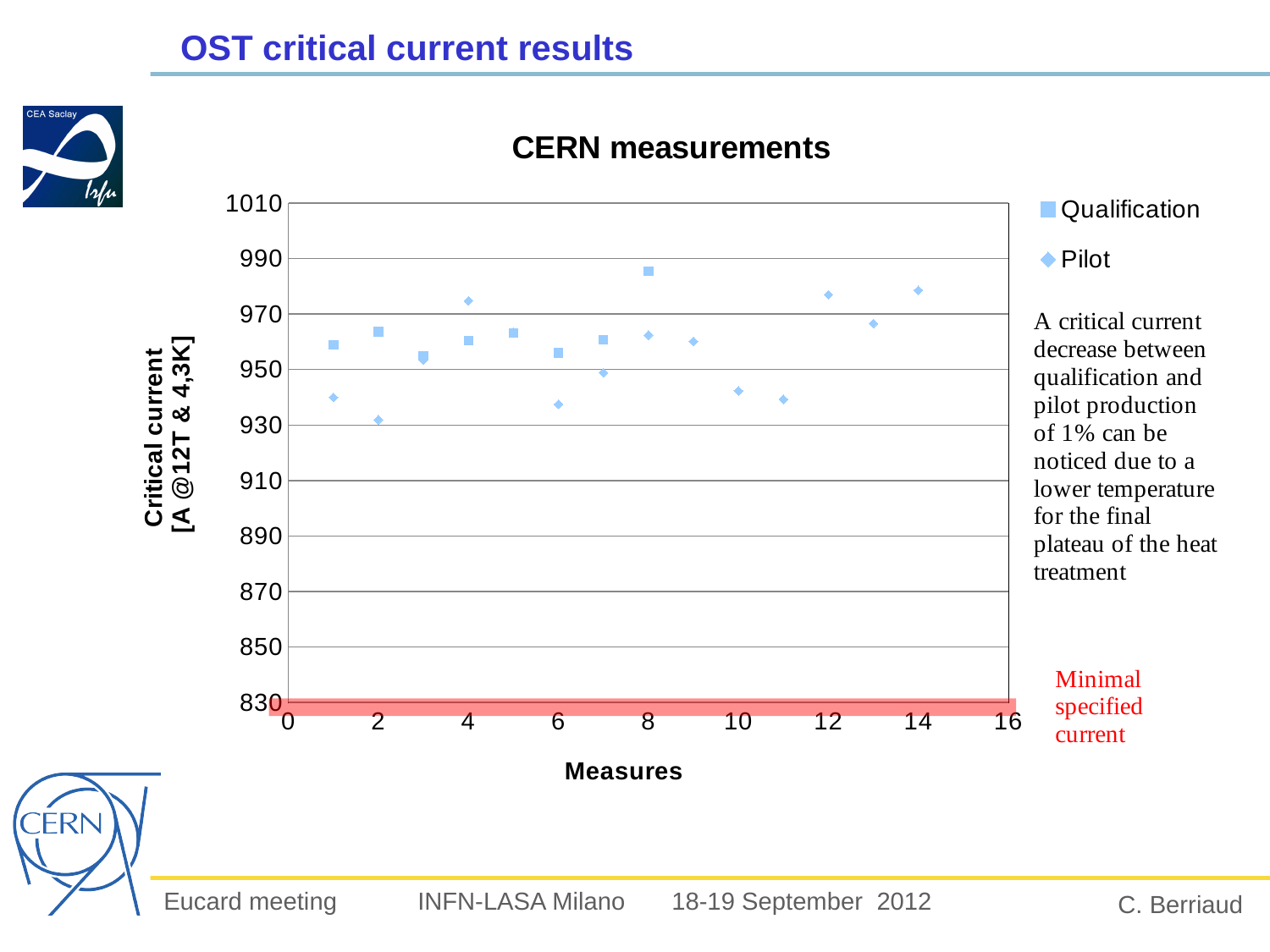
Is the Pilot value at measure 2 greater or less than 950? less At which measure number does the Qualification series reach its highest value? 8 How many Qualification points are plotted on the chart? 8 What are the two series named in the legend? Qualification and Pilot At measure 4, which series has the larger value, Qualification or Pilot? Pilot Is the Pilot value at measure 14 greater or less than 970? greater Is the Pilot value at measure 11 greater or less than 950? less At measure 2, which series has the larger value, Qualification or Pilot? Qualification How many series does the chart legend list? 2 What kind of chart is shown on the slide? scatter chart What is the title of the chart? CERN measurements